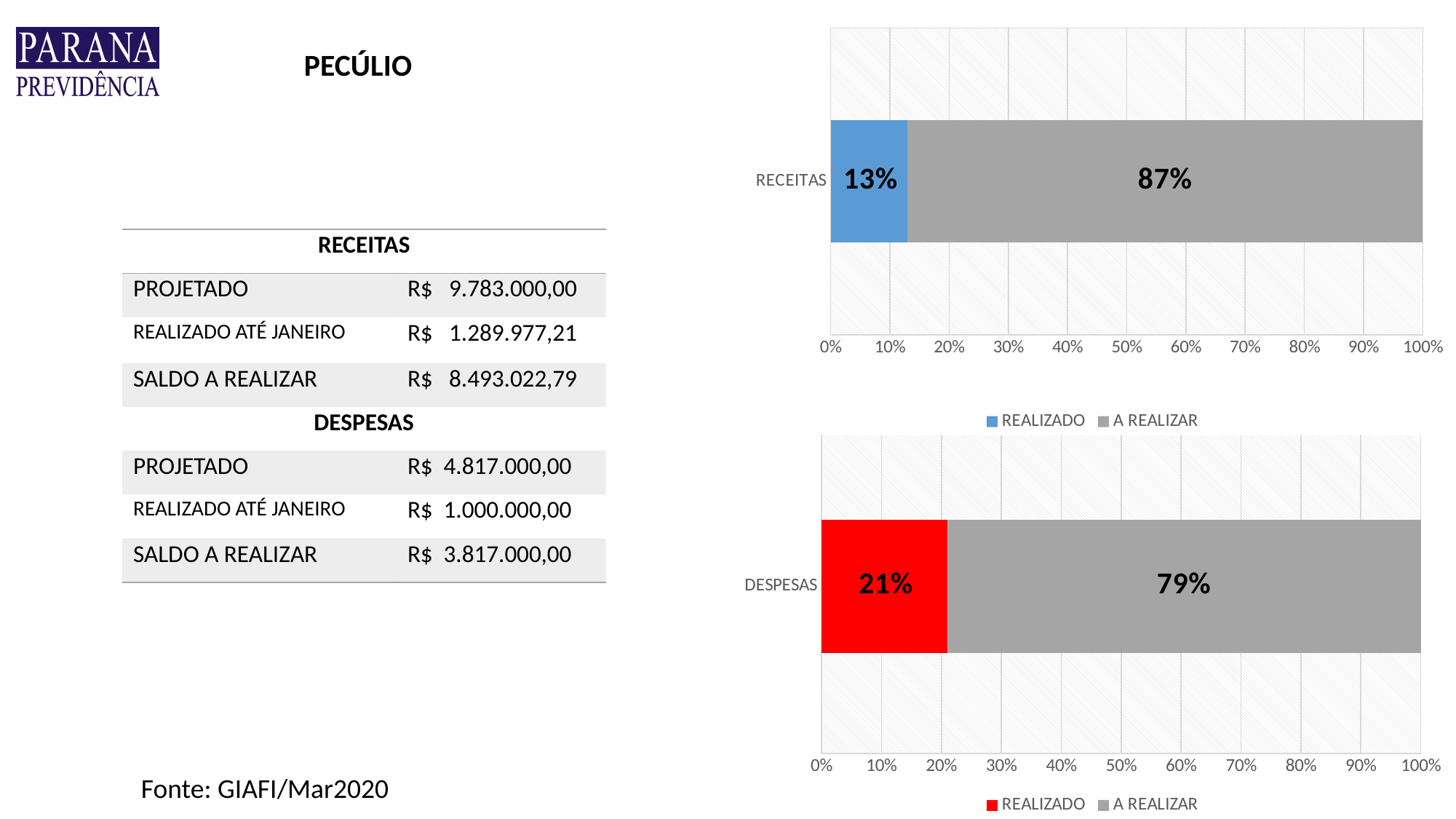
In the top chart (RECEITAS), what percentage is shown for A REALIZAR? 87% In the top chart (RECEITAS), what percentage is shown for REALIZADO? 13% In the top chart (RECEITAS), which series has the larger share, REALIZADO or A REALIZAR? A REALIZAR In the bottom chart (DESPESAS), what percentage is shown for A REALIZAR? 79% In the bottom chart (DESPESAS), what is the total of the stacked bar? 100% In the bottom chart (DESPESAS), what percentage is shown for REALIZADO? 21% In the bottom chart (DESPESAS), what colour is the REALIZADO segment? Red How many series does the legend of the bottom chart (DESPESAS) list? 2 In the bottom chart (DESPESAS), which series has the smaller share? REALIZADO In the bottom chart (DESPESAS), what is the difference between the A REALIZAR and REALIZADO percentages? 58% In the top chart (RECEITAS), what is the difference between the A REALIZAR and REALIZADO percentages? 74% What kind of chart is the top chart (RECEITAS)? Stacked horizontal bar chart